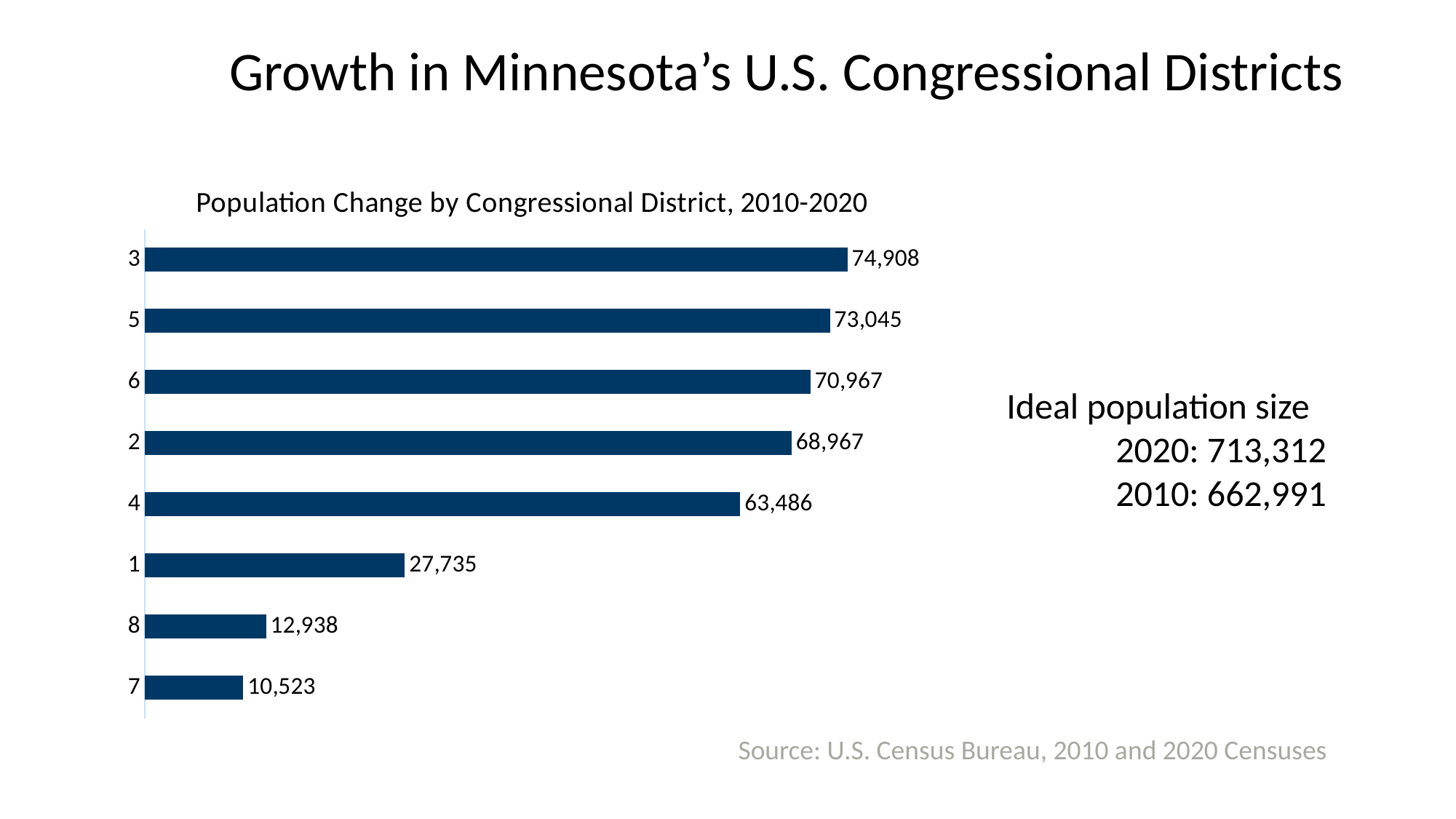
Which congressional district has the highest population change? 3 What is the difference in population change between district 1 and district 8? 14,797 What type of chart is shown on the slide? Bar chart Which district has a larger population change, district 2 or district 4? 2 What is the difference in population change between district 3 and district 7? 64,385 What is the source cited for the chart data? U.S. Census Bureau, 2010 and 2020 Censuses Which congressional district has the lowest population change? 7 What is the population change for congressional district 7? 10,523 What is the population change for congressional district 4? 63,486 How many congressional districts are shown in the chart? 8 What is the population change for congressional district 3? 74,908 What is the title of the chart? Population Change by Congressional District, 2010-2020